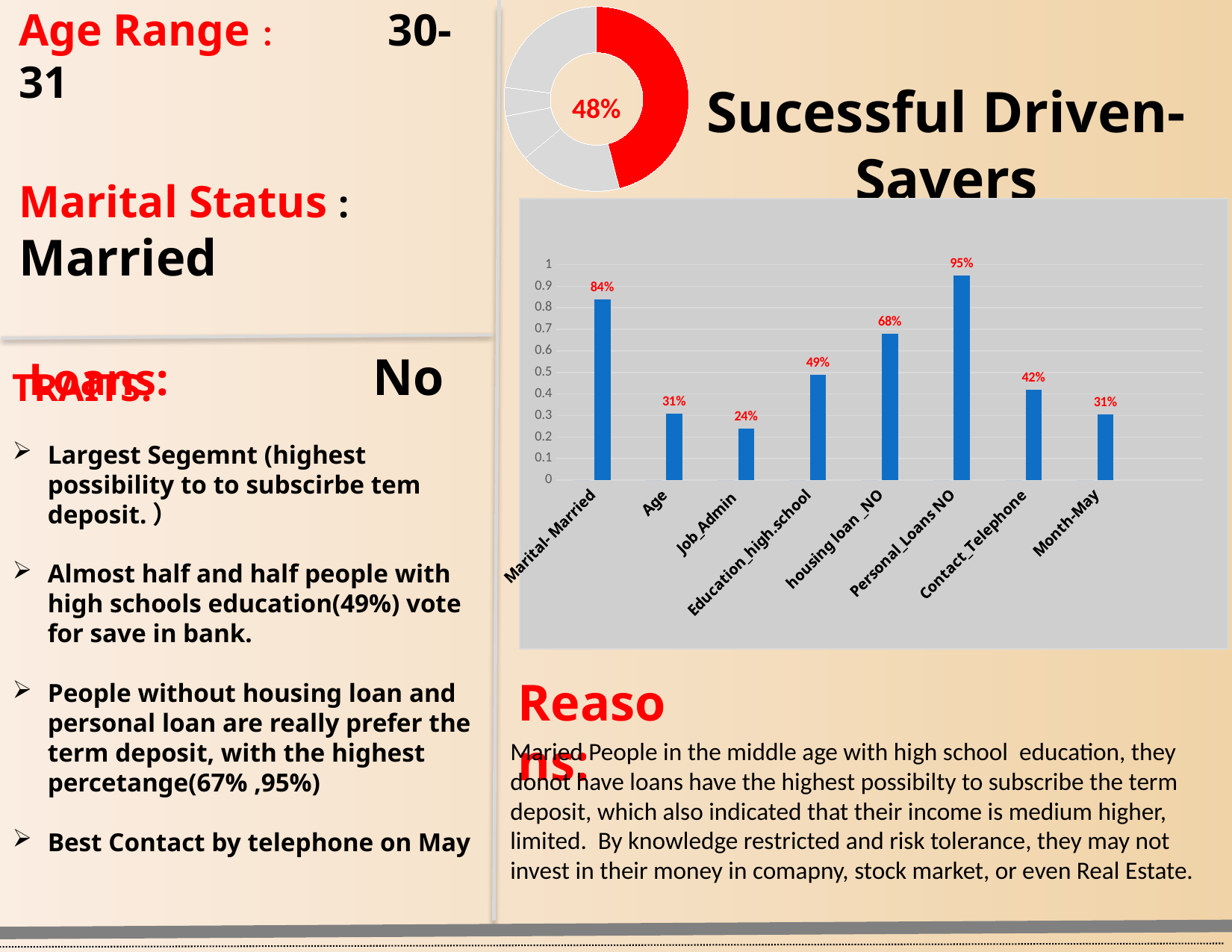
In the donut chart at the top of the slide, what value is printed for the red slice? 48% What kind of chart is the chart in the grey panel on the right of the slide? bar chart In the bar chart, what is the difference between the values for Personal_Loans NO and housing loan _NO? 27% In the bar chart, what is the value for Personal_Loans NO? 95% In the bar chart, which category has the lowest value? Job_Admin In the bar chart, what is the value for Month-May? 31% In the bar chart, what colour are the bars? blue In the bar chart, which is larger: housing loan _NO or Contact_Telephone? housing loan _NO In the bar chart, what is the value for Education_high.school? 49% How many categories are shown in the bar chart? 8 In the bar chart, what is the difference between the values for Marital- Married and Age? 53% In the bar chart, which category has the highest value? Personal_Loans NO